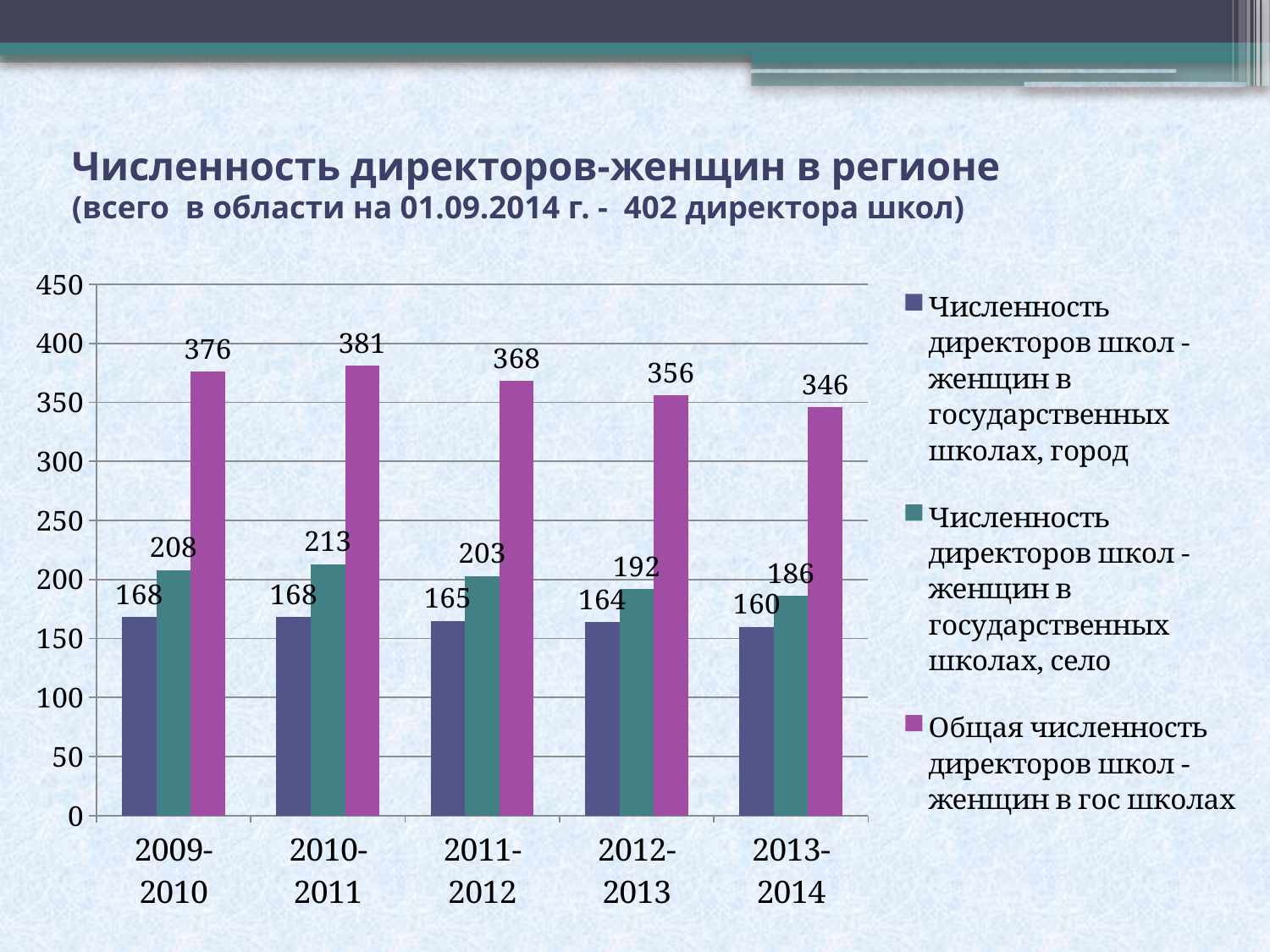
Which is larger in 2012-2013: the city value (город) or the village value (село)? село (192) In which school year is the city series (город) lowest? 2013-2014 What is the difference between the total values for 2009-2010 and 2013-2014? 30 How many school years are shown on the x axis? 5 In which school year is the total number of women school directors (Общая численность) highest? 2010-2011 Does the total number of women school directors (Общая численность) rise or fall from 2010-2011 to 2013-2014? Fall What colour are the bars for the total series (Общая численность директоров школ - женщин в гос школах)? Purple (magenta) What is the value for the village series (село) in 2010-2011? 213 What is the value for the city series (Численность директоров школ - женщин в государственных школах, город) in 2011-2012? 165 What kind of chart is shown on the slide? Bar chart How many series does the legend list? 3 What is the total number of women school directors (Общая численность) in 2013-2014? 346